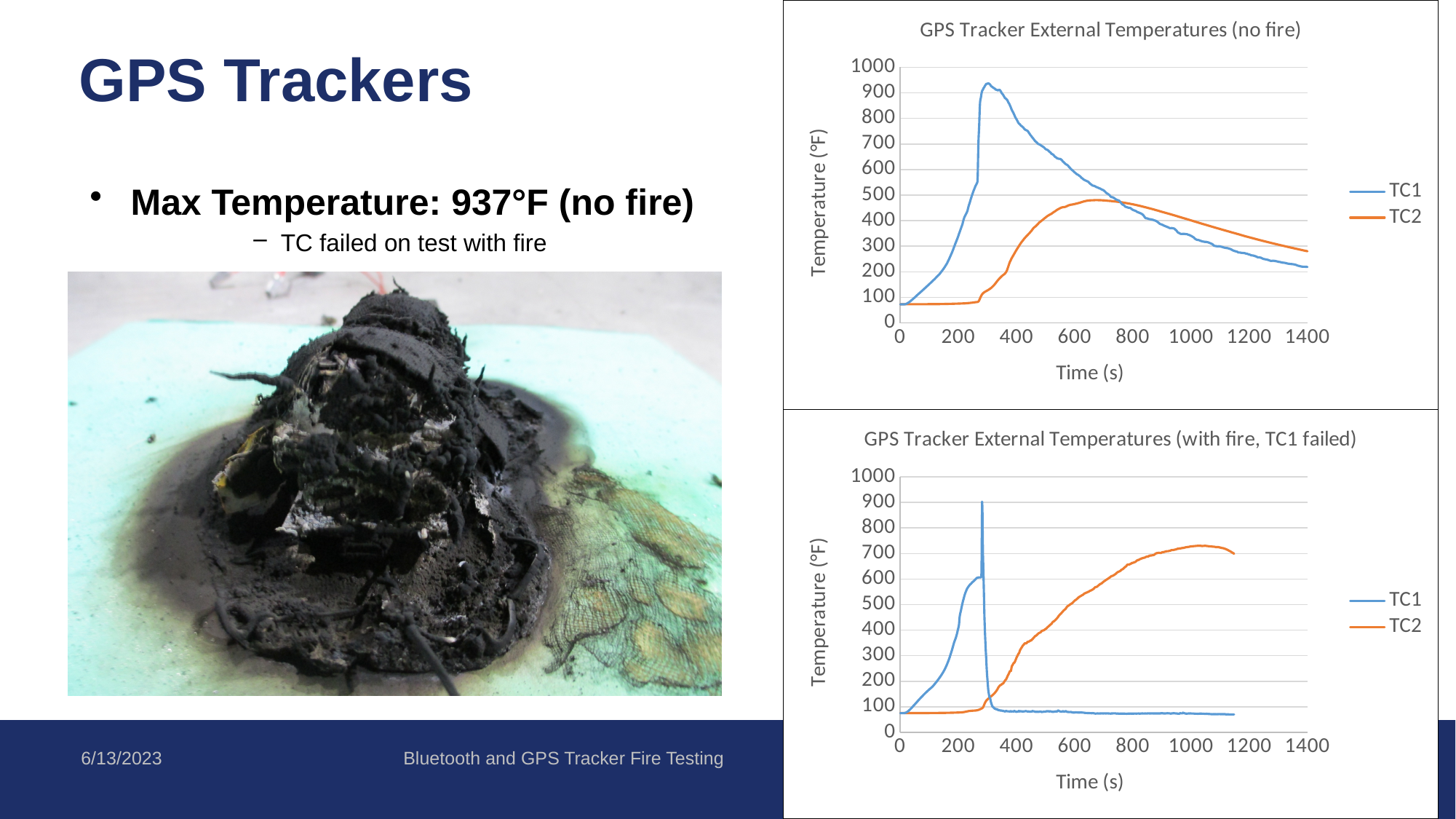
In the chart titled "GPS Tracker External Temperatures (no fire)", what kind of chart is shown? line chart In the chart titled "GPS Tracker External Temperatures (with fire, TC1 failed)", does TC2 rise or fall between 400 s and 1000 s? rise In the chart titled "GPS Tracker External Temperatures (with fire, TC1 failed)", how many series does the legend list? 2 In the chart titled "GPS Tracker External Temperatures (with fire, TC1 failed)", which series is higher at 1000 s, TC1 or TC2? TC2 In the chart titled "GPS Tracker External Temperatures (with fire, TC1 failed)", is the value of TC1 at 800 s greater or less than 200? less In the chart titled "GPS Tracker External Temperatures (no fire)", is the peak value of TC1 greater or less than 900? greater What is the label of the y axis on the chart titled "GPS Tracker External Temperatures (no fire)"? Temperature (°F) In the chart titled "GPS Tracker External Temperatures (no fire)", is the peak value of TC2 greater or less than 500? less In the chart titled "GPS Tracker External Temperatures (no fire)", does TC1 rise or fall between 400 s and 1400 s? fall In the chart titled "GPS Tracker External Temperatures (no fire)", which series reaches the higher peak temperature, TC1 or TC2? TC1 In the chart titled "GPS Tracker External Temperatures (no fire)", what colour is the TC2 line? orange